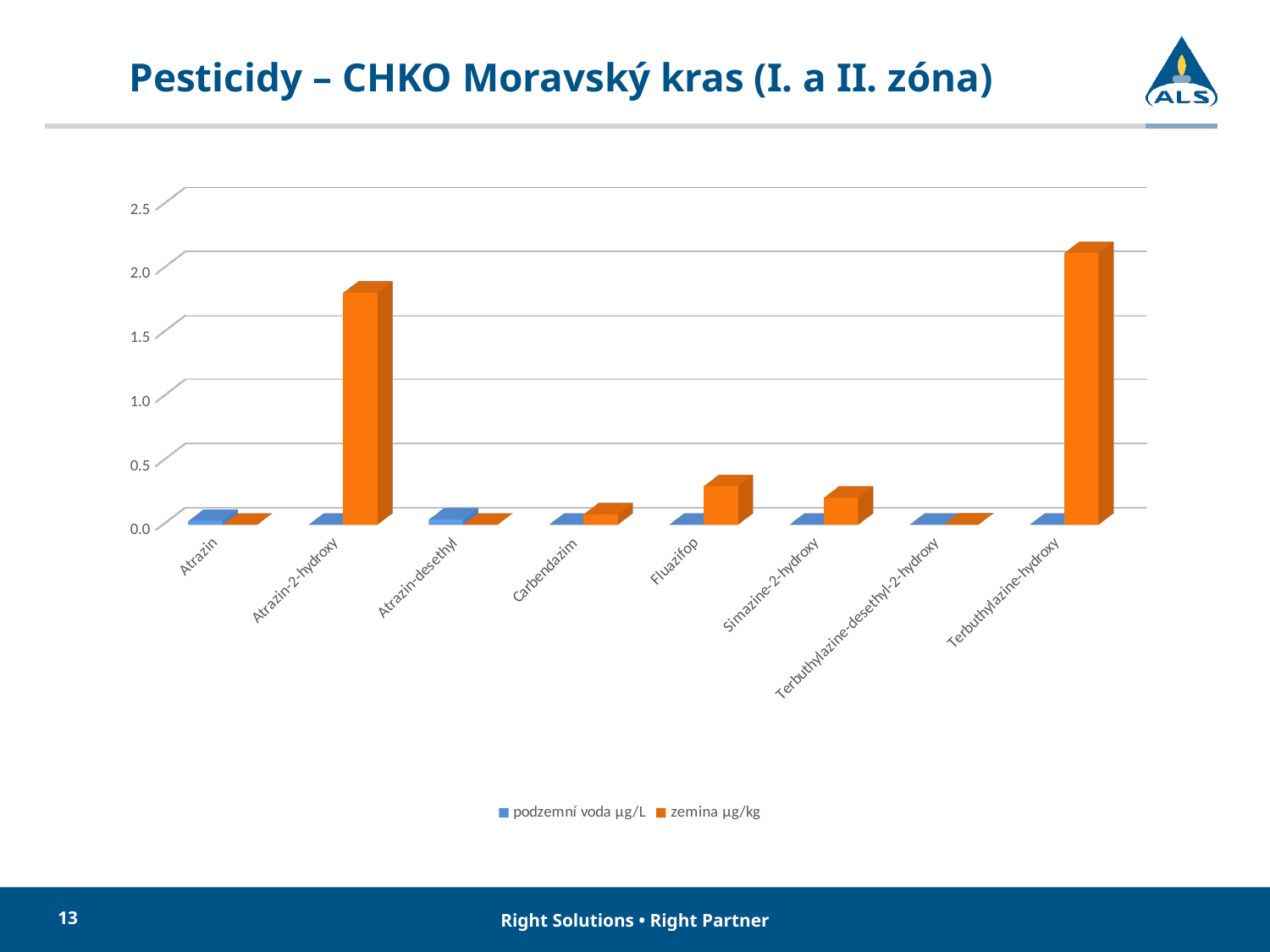
How many pesticide categories are shown on the x axis? 8 Which category has the highest value for the zemina µg/kg series? Terbuthylazine-hydroxy What kind of chart is shown on the slide? bar chart Is the zemina µg/kg value for Terbuthylazine-hydroxy greater or less than 2.0? greater Is the zemina µg/kg value for Fluazifop greater or less than 0.5? less Which has the larger zemina µg/kg value, Carbendazim or Fluazifop? Fluazifop Which has the larger zemina µg/kg value, Atrazin-2-hydroxy or Terbuthylazine-hydroxy? Terbuthylazine-hydroxy What is the title of the slide containing the chart? Pesticidy – CHKO Moravský kras (I. a II. zóna) Is the zemina µg/kg value for Atrazin-2-hydroxy greater or less than 2.0? less How many series does the legend list? 2 What are the two series named in the legend? podzemní voda µg/L and zemina µg/kg